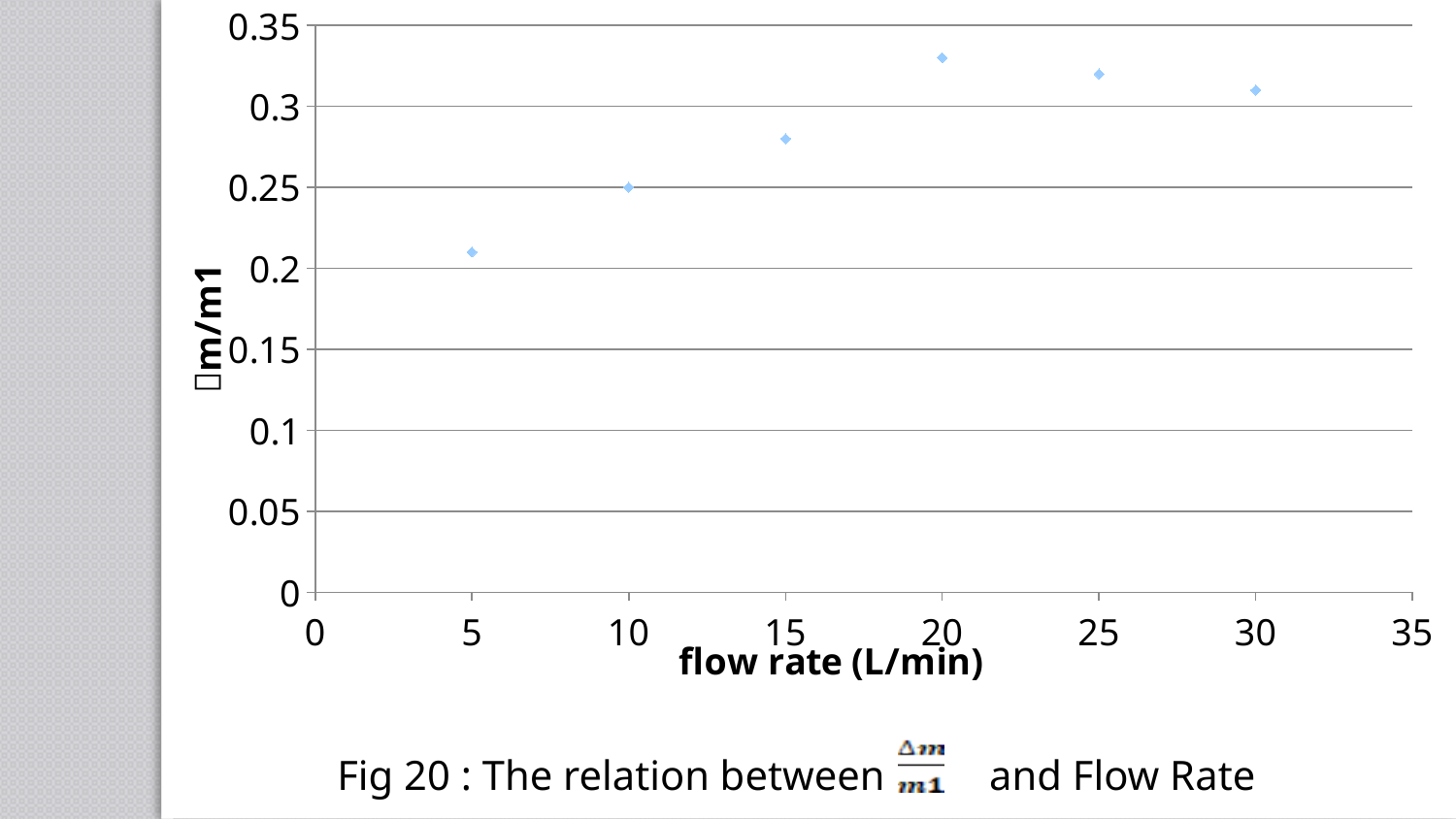
Is the value of Δm/m1 at a flow rate of 5 L/min greater or less than 0.2? greater Do the values rise or fall as the flow rate increases from 5 to 20 L/min? rise Is the value of Δm/m1 at a flow rate of 15 L/min greater or less than 0.3? less What is the label of the x axis? flow rate (L/min) What kind of chart is shown on the slide? scatter chart Is the value of Δm/m1 at a flow rate of 20 L/min greater or less than 0.3? greater How many data points are plotted on the chart? 6 At which flow rate is Δm/m1 lowest? 5 What is the value of Δm/m1 at a flow rate of 10 L/min? 0.25 Which has the larger Δm/m1 value, a flow rate of 10 L/min or 15 L/min? 15 L/min At which flow rate is Δm/m1 highest? 20